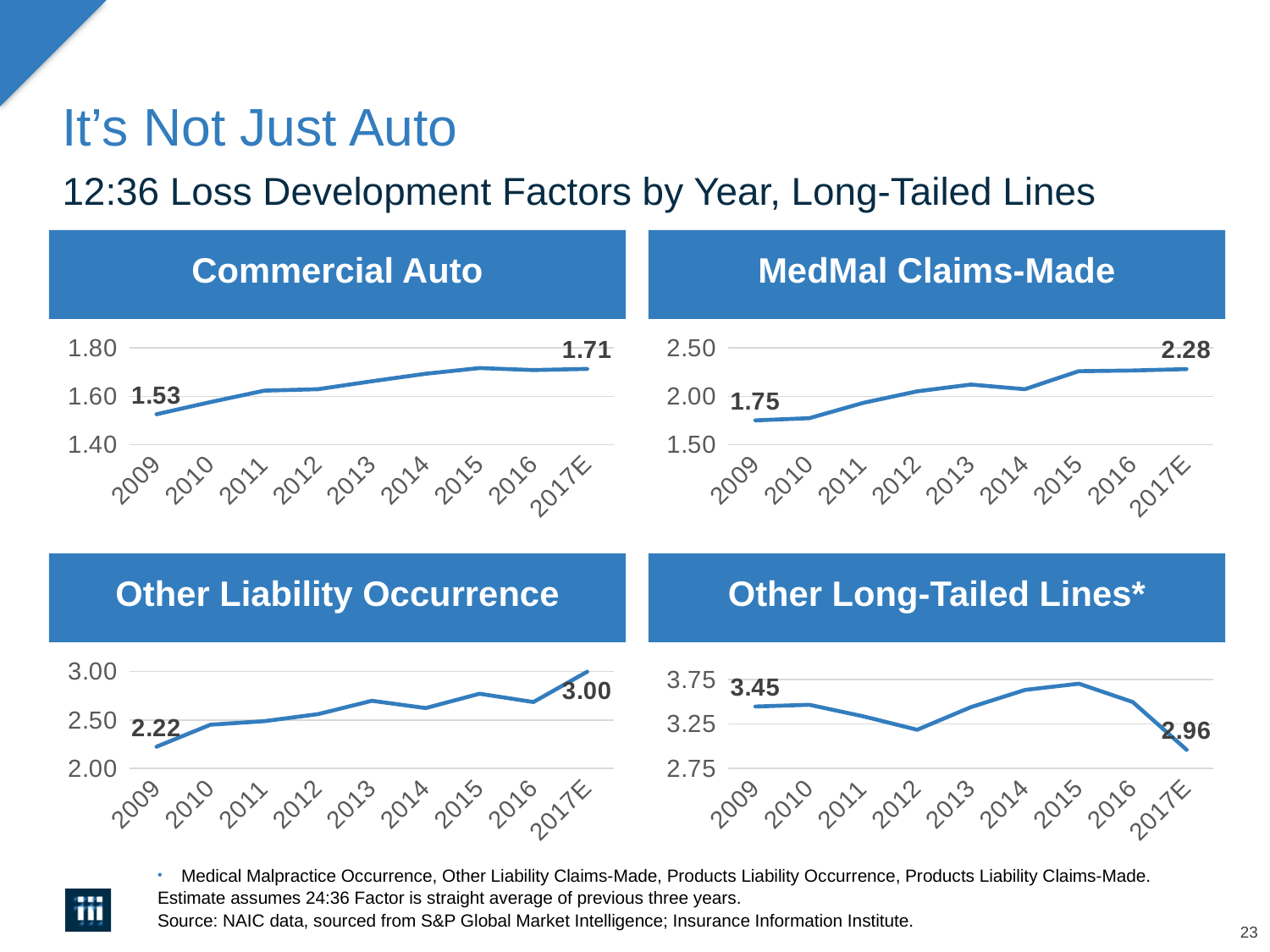
What kind of chart is used for Other Liability Occurrence? Line chart How many years are plotted on the x axis of the Commercial Auto chart? 9 In the Other Long-Tailed Lines* chart, which is larger, the 2009 value or the 2017E value? 2009 In the MedMal Claims-Made chart, what is the difference between the 2017E value and the 2009 value? 0.53 In the Commercial Auto chart, what is the loss development factor for 2009? 1.53 In the MedMal Claims-Made chart, is the value for 2013 greater or less than 2.00? greater In the Other Liability Occurrence chart, what is the value for 2009? 2.22 In the Other Long-Tailed Lines* chart, is the value for 2015 greater or less than 3.25? greater In the Other Long-Tailed Lines* chart, what is the value for 2017E? 2.96 In the Other Liability Occurrence chart, how much higher is the 2017E value than the 2009 value? 0.78 In the Commercial Auto chart, what is the value for 2017E? 1.71 In the MedMal Claims-Made chart, what is the value for 2017E? 2.28